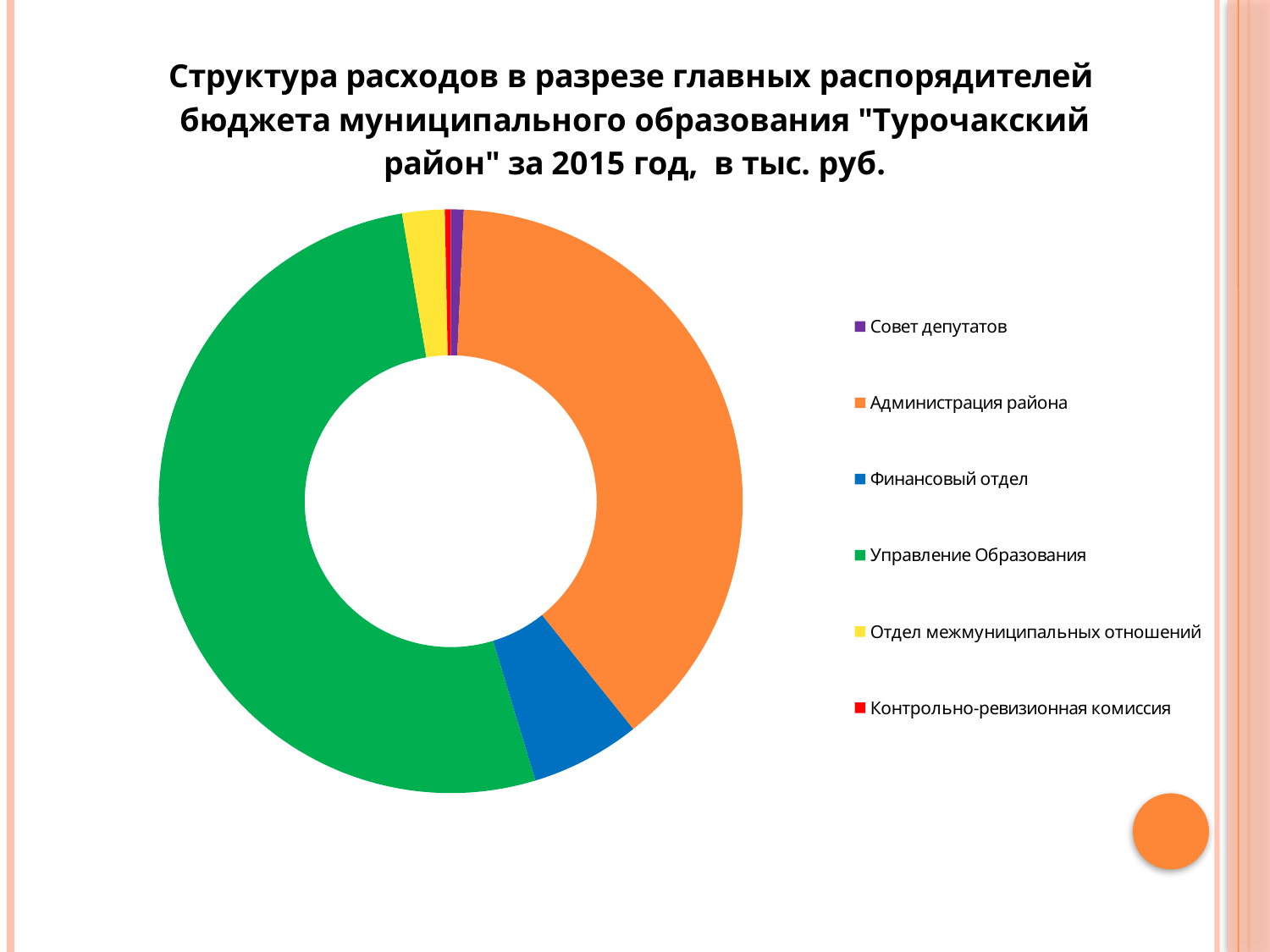
Which is larger: the share for Администрация района or the share for Финансовый отдел? Администрация района How many categories does the legend of the chart list? 6 What kind of chart is shown on the slide? doughnut (pie) chart Which is larger: the share for Отдел межмуниципальных отношений or the share for Контрольно-ревизионная комиссия? Отдел межмуниципальных отношений For which year does the chart show the expenditure structure, according to the title? 2015 What colour represents Администрация района in the chart? orange Which category has the largest share of the chart? Управление Образования Which is larger: the share for Финансовый отдел or the share for Отдел межмуниципальных отношений? Финансовый отдел